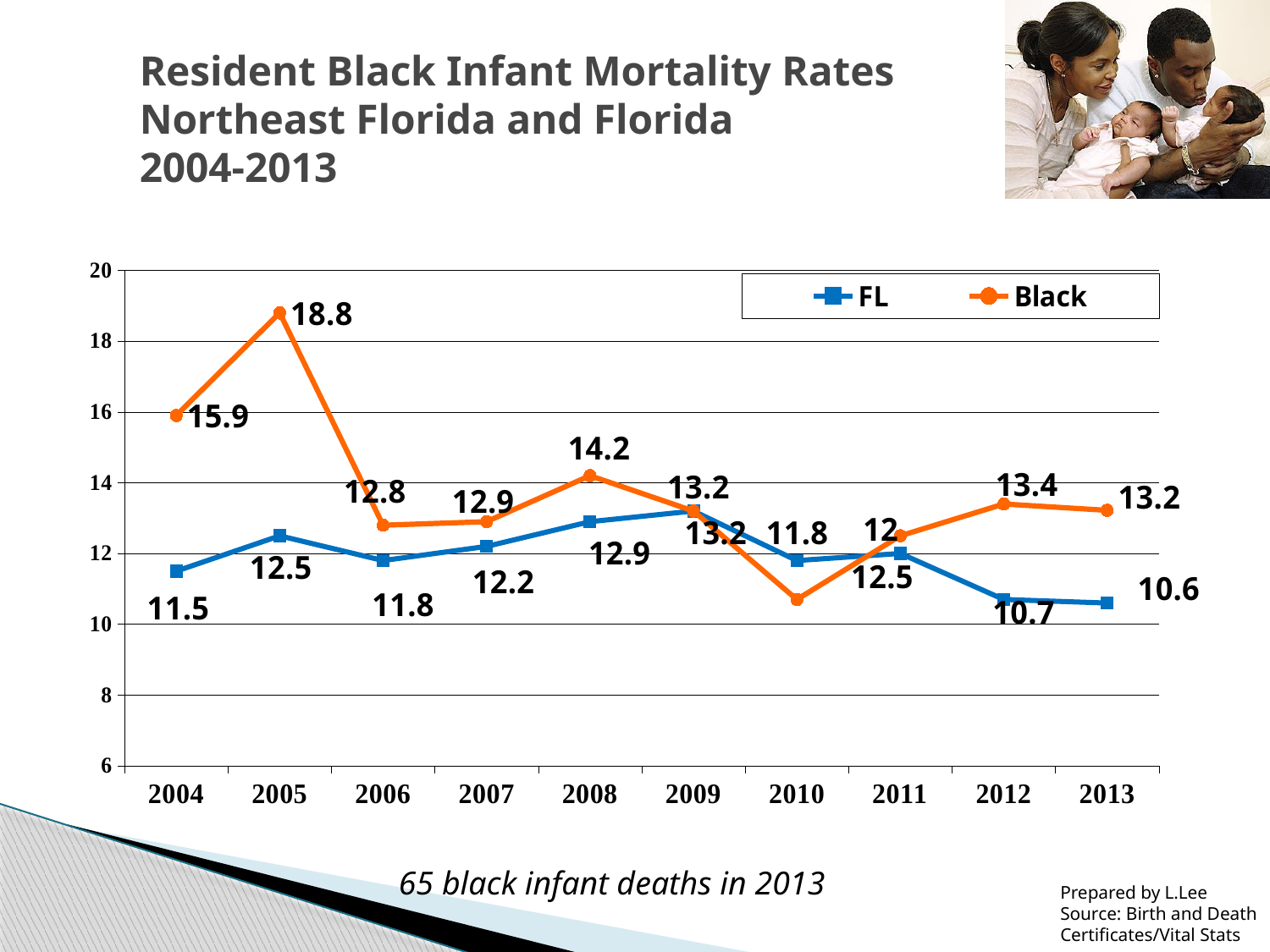
What is the difference between the Black and FL values in 2013? 2.6 What is the difference between the Black values for 2005 and 2004? 2.9 Is the Black value for 2010 greater or less than 12? less Does the FL series rise or fall from 2011 to 2013? fall How many series does the legend list? 2 What kind of chart is shown on the slide? line chart What is the Black infant mortality rate for 2005? 18.8 What is the FL value for 2013? 10.6 In which year is the Black series at its highest? 2005 What is the Black value for 2008? 14.2 In 2013, which series has the higher value, FL or Black? Black How many years are plotted along the x axis? 10